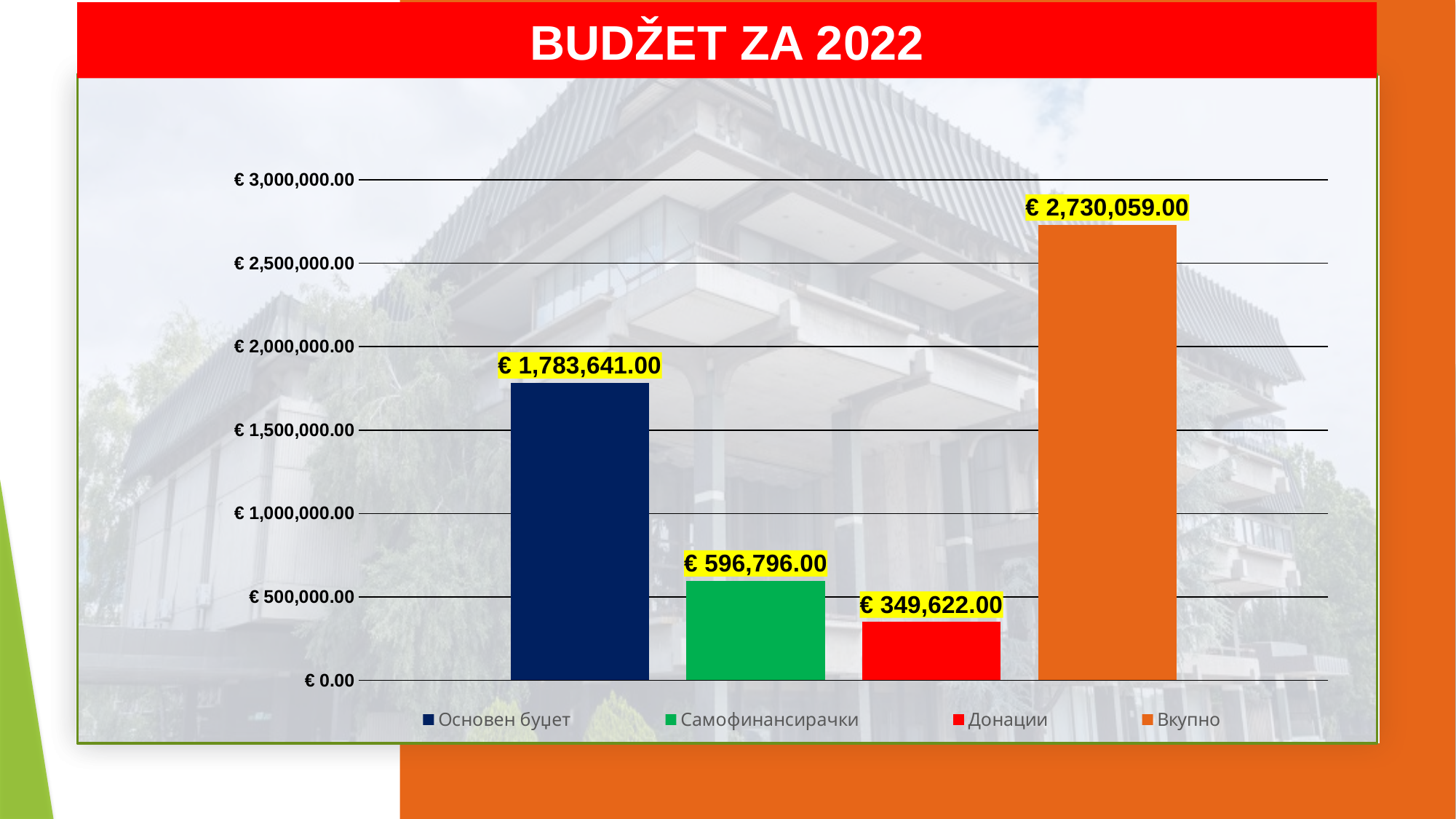
Which category has the highest value? Вкупно What is the difference between Самофинансирачки and Донации? € 247,174.00 What kind of chart is shown on the slide? Bar chart Which is larger, Самофинансирачки or Донации? Самофинансирачки What is the value for Основен буџет? € 1,783,641.00 What is the value for Самофинансирачки? € 596,796.00 How many bars are shown in the chart? 4 What is the value for Донации? € 349,622.00 What is the title of the slide? BUDŽET ZA 2022 What is the difference between Основен буџет and Самофинансирачки? € 1,186,845.00 What is the value for Вкупно? € 2,730,059.00 Which category has the lowest value? Донации